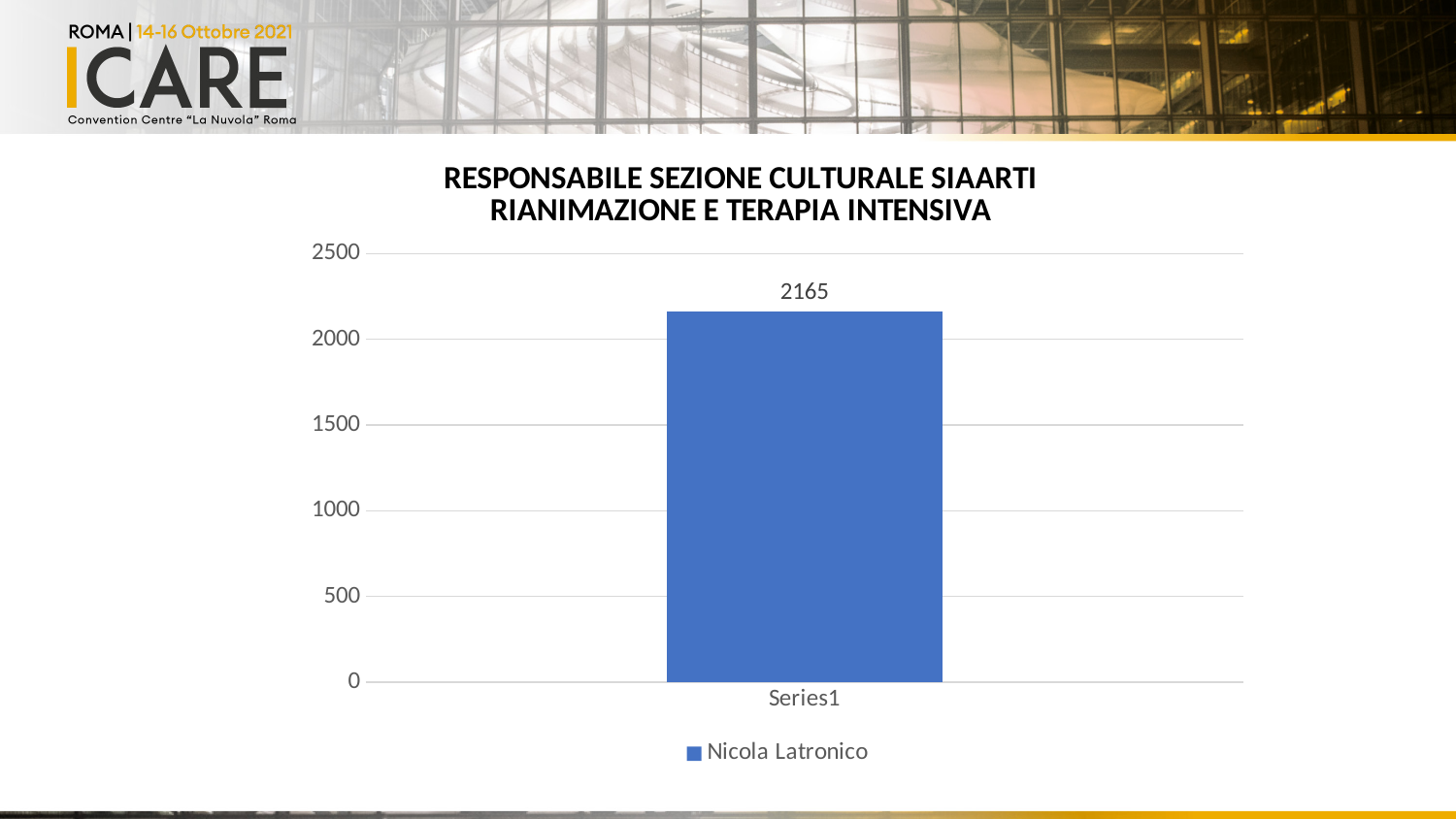
What is the highest value shown on the y axis? 2500 What kind of chart is shown on the slide? bar chart What is the title of the chart? RESPONSABILE SEZIONE CULTURALE SIAARTI RIANIMAZIONE E TERAPIA INTENSIVA Is the value for Series1 greater or less than 2500? less What is the category label shown on the x axis? Series1 What is the value of the bar for Series1? 2165 How many series does the legend list? 1 How many bars are plotted in the chart? 1 What is the name of the series shown in the legend? Nicola Latronico Is the value for Series1 greater or less than 2000? greater